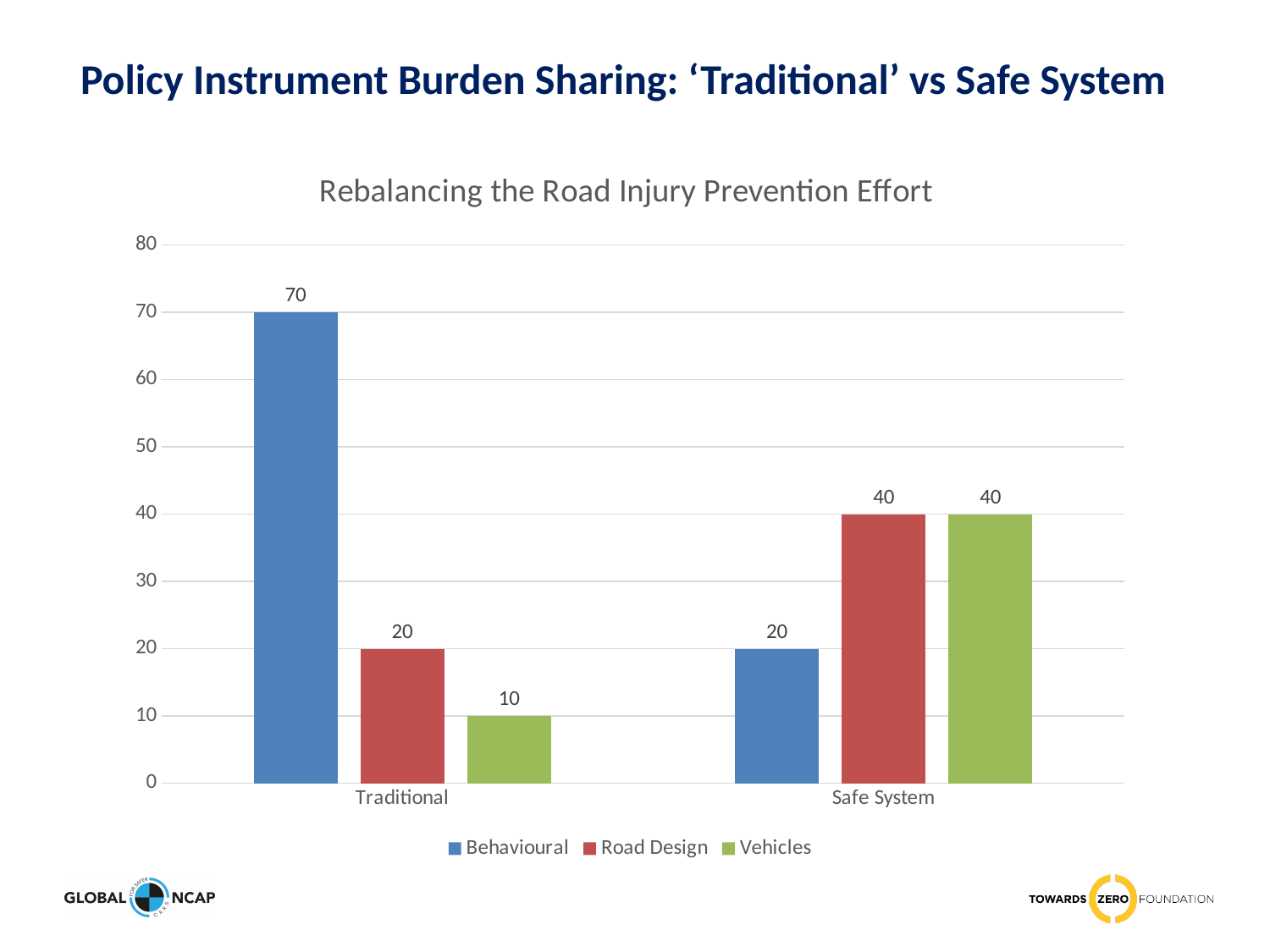
What is the value for Vehicles in the Traditional category? 10 How many categories are shown on the x axis? 2 Which series has the highest value in the Traditional category? Behavioural What is the title of the chart? Rebalancing the Road Injury Prevention Effort How many series does the legend list? 3 What is the value for Road Design in the Safe System category? 40 What is the value for Behavioural in the Traditional category? 70 What is the value for Behavioural in the Safe System category? 20 Which is larger: Vehicles for Traditional or Vehicles for Safe System? Vehicles for Safe System Which series has the lowest value in the Traditional category? Vehicles What is the difference between the Behavioural value for Traditional and the Behavioural value for Safe System? 50 What kind of chart is shown on the slide? Bar chart